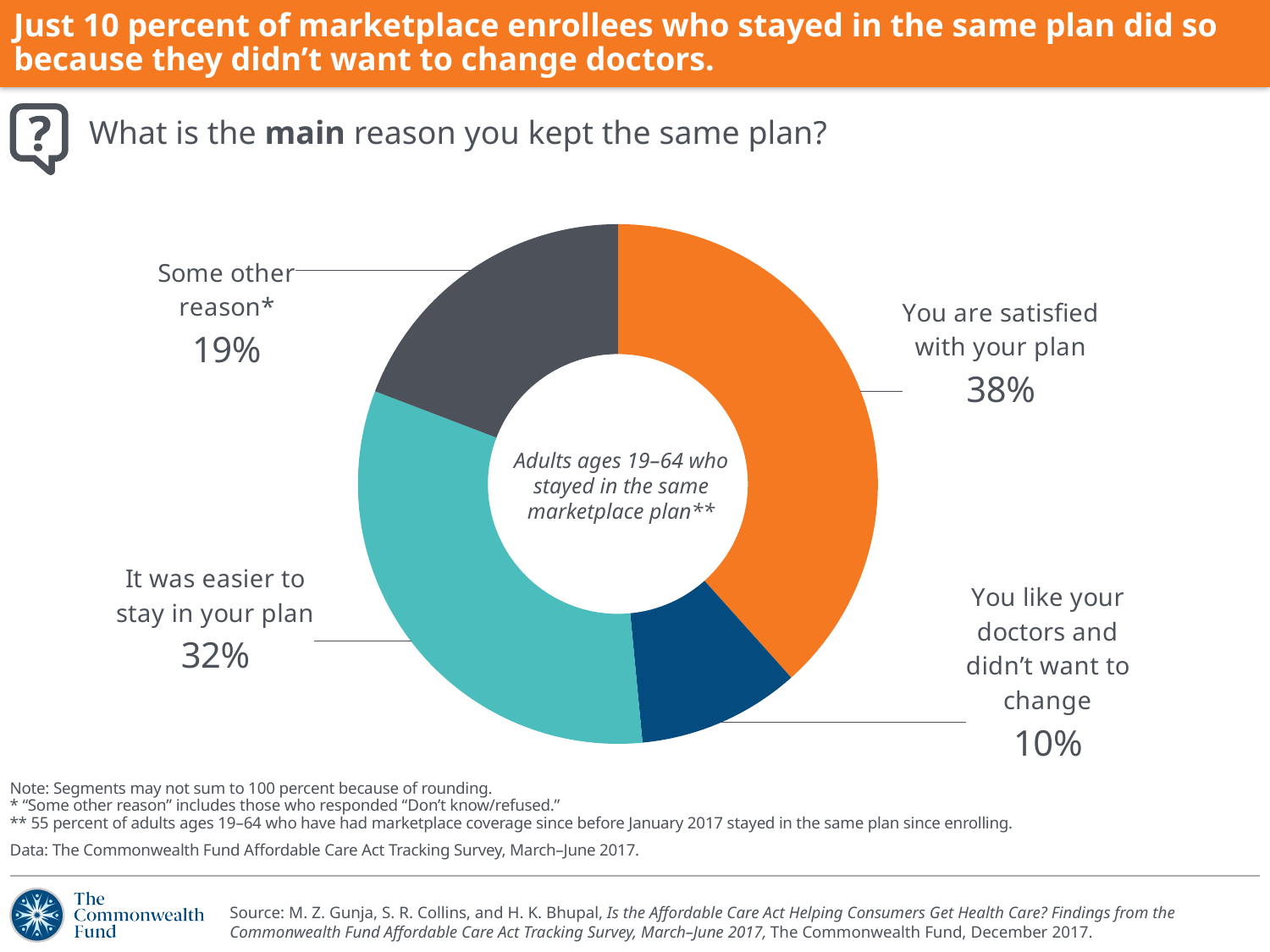
What percentage gave 'Some other reason' as the main reason for keeping the same plan? 19% Which reason for keeping the same plan has the largest share? You are satisfied with your plan Which is larger: the share for 'It was easier to stay in your plan' or the share for 'Some other reason'? It was easier to stay in your plan What is the difference in percentage points between 'You are satisfied with your plan' and 'It was easier to stay in your plan'? 6 percentage points What share of respondents said it was easier to stay in their plan? 32% What type of chart is shown on the slide? Donut (pie) chart Which reason for keeping the same plan has the smallest share? You like your doctors and didn't want to change What percentage of respondents said they kept the same plan because they are satisfied with their plan? 38% What is the difference in percentage points between 'Some other reason' and 'You like your doctors and didn't want to change'? 9 percentage points How many reasons (segments) are shown in the chart? 4 What percentage said they like their doctors and didn't want to change? 10% What text appears in the center of the donut chart? Adults ages 19–64 who stayed in the same marketplace plan**